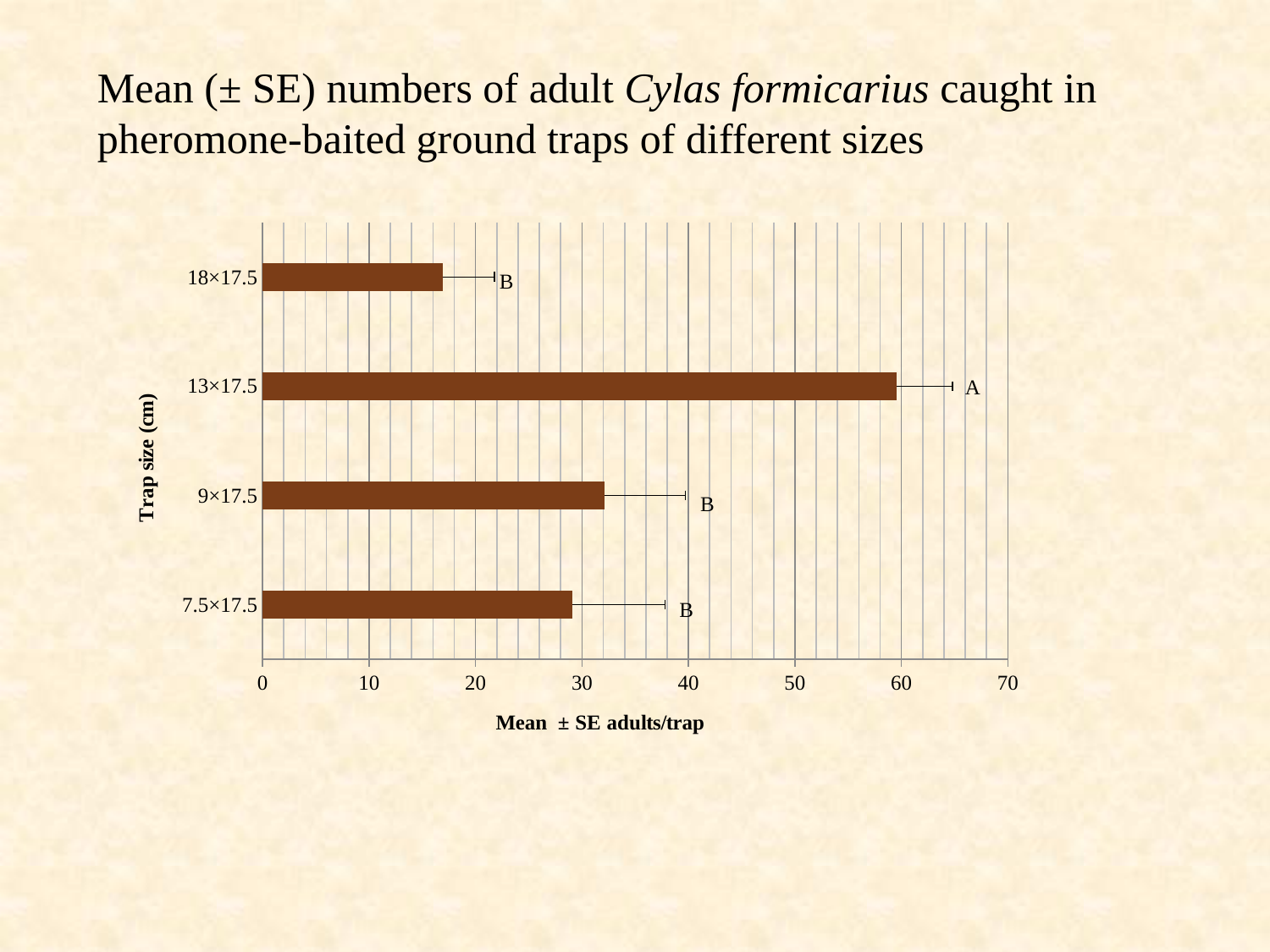
Which trap size has the larger mean number of adults per trap, 18×17.5 or 7.5×17.5? 7.5×17.5 How many trap sizes are plotted on the chart? 4 Is the mean number of adults per trap for the 13×17.5 trap greater or less than 50? greater Which statistical grouping letter is shown next to the bar for the 13×17.5 trap? A Which trap size caught the highest mean number of adults per trap? 13×17.5 Is the mean number of adults per trap for the 7.5×17.5 trap greater or less than 20? greater What kind of chart is shown on the slide? bar chart Which trap size caught the lowest mean number of adults per trap? 18×17.5 Is the mean number of adults per trap for the 9×17.5 trap greater or less than 40? less What is the title of the horizontal axis of the chart? Mean ± SE adults/trap Which trap size has the larger mean number of adults per trap, 13×17.5 or 9×17.5? 13×17.5